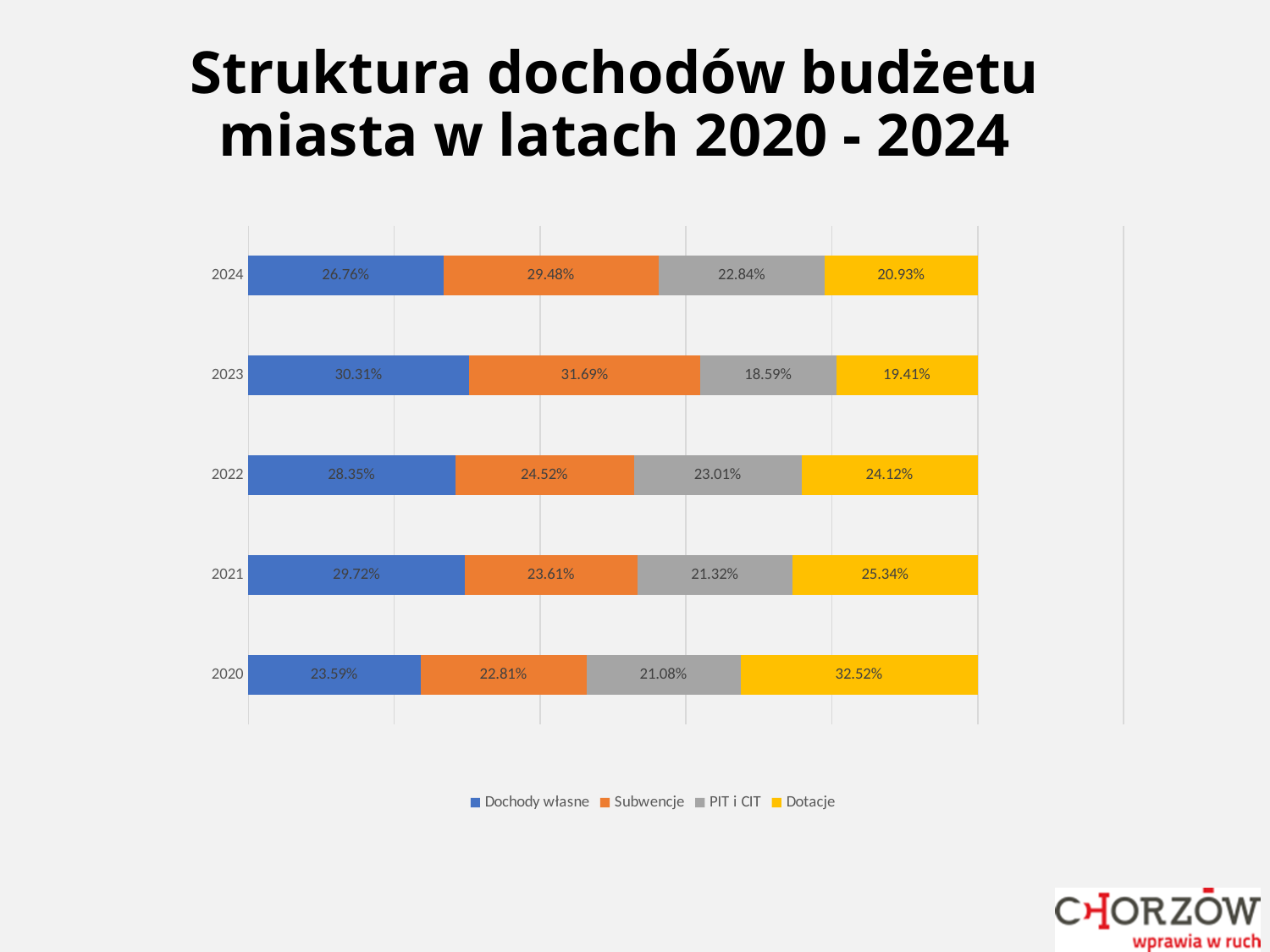
How many series does the legend list? 4 What is the value for Subwencje in 2023? 31.69% In 2022, which is larger: Dochody własne or Dotacje? Dochody własne How many years are shown on the chart? 5 What is the difference between the Subwencje share in 2024 and in 2020? 6.67 percentage points In which year is the Dotacje share the highest? 2020 What kind of chart is shown on the slide? Stacked bar chart What is the value for PIT i CIT in 2022? 23.01% What is the value for Dotacje in 2020? 32.52% Which colour represents Dotacje in the legend? Yellow What is the value for Dochody własne in 2024? 26.76% In which year is the PIT i CIT share the lowest? 2023